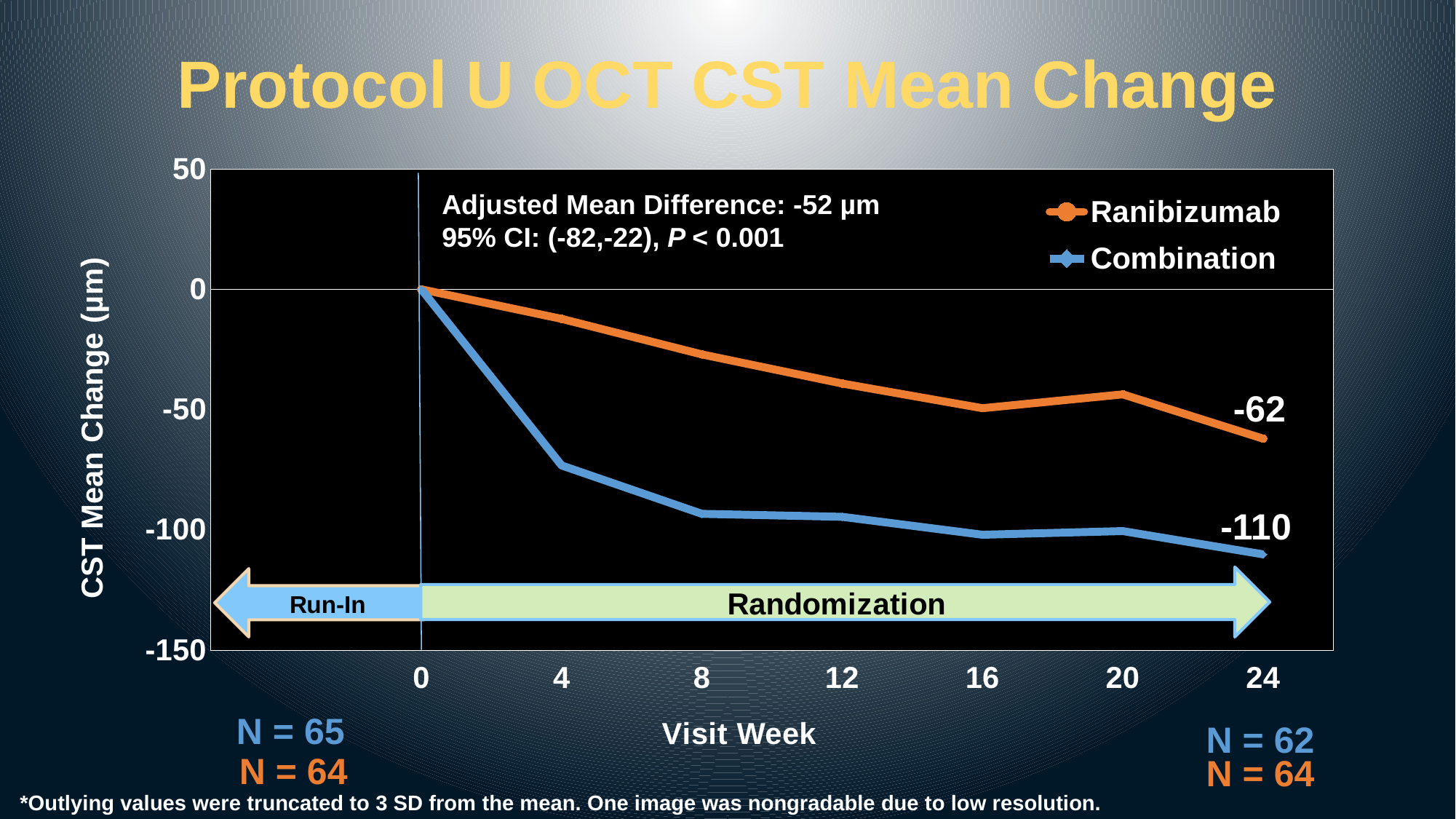
Do the values for Combination rise or fall from visit week 0 to visit week 24? fall Is the value for Combination at visit week 4 greater or less than -50? less At visit week 24, which series has the larger decrease in CST: Ranibizumab or Combination? Combination Is the value for Ranibizumab at visit week 8 greater or less than -50? greater What is the title of the chart? Protocol U OCT CST Mean Change What is the value for Ranibizumab at visit week 24? -62 How many series does the legend list? 2 What is the CST mean change for both series at visit week 0? 0 What is the difference between the Ranibizumab and Combination values at visit week 24? 48 What is the value for Combination at visit week 24? -110 What kind of chart is shown on the slide? line chart How many visit weeks are marked on the x axis? 7